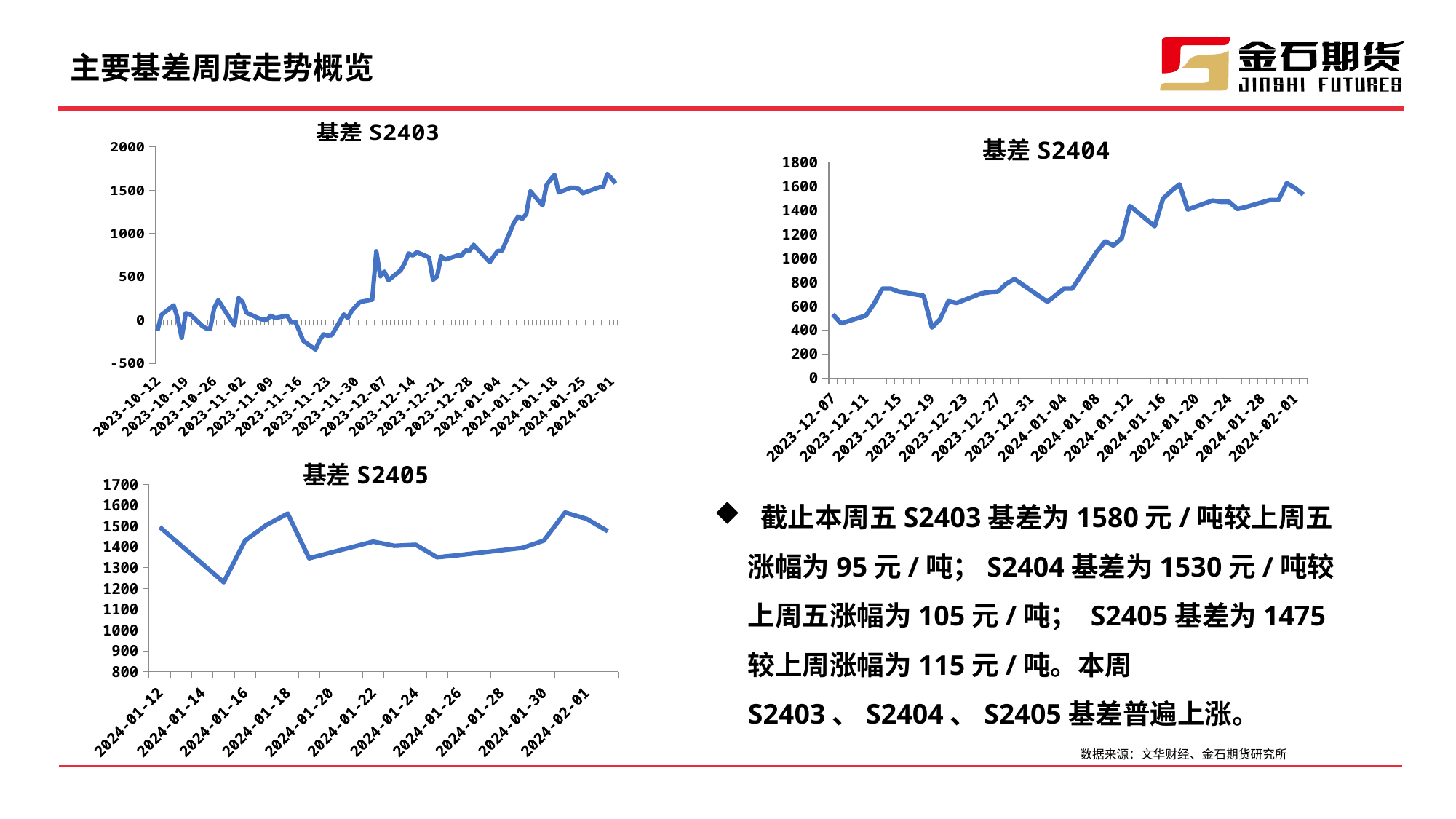
In the 基差 S2404 chart, is the value at 2024-01-16 greater or less than 1400? greater In the 基差 S2403 chart, is the value at 2023-11-23 greater or less than 0? less How many charts are shown on the slide? 3 In the 基差 S2404 chart, which is larger, the value at 2023-12-07 or the value at 2024-02-01? 2024-02-01 What is the title of the chart in the top-right of the slide? 基差 S2404 In the 基差 S2403 chart, do the values overall rise or fall from 2023-10-12 to 2024-02-01? rise In the 基差 S2405 chart, is the value at 2024-01-18 greater or less than 1500? greater What kind of chart is the 基差 S2403 chart? line chart What is the highest value shown on the y axis of the 基差 S2404 chart? 1800